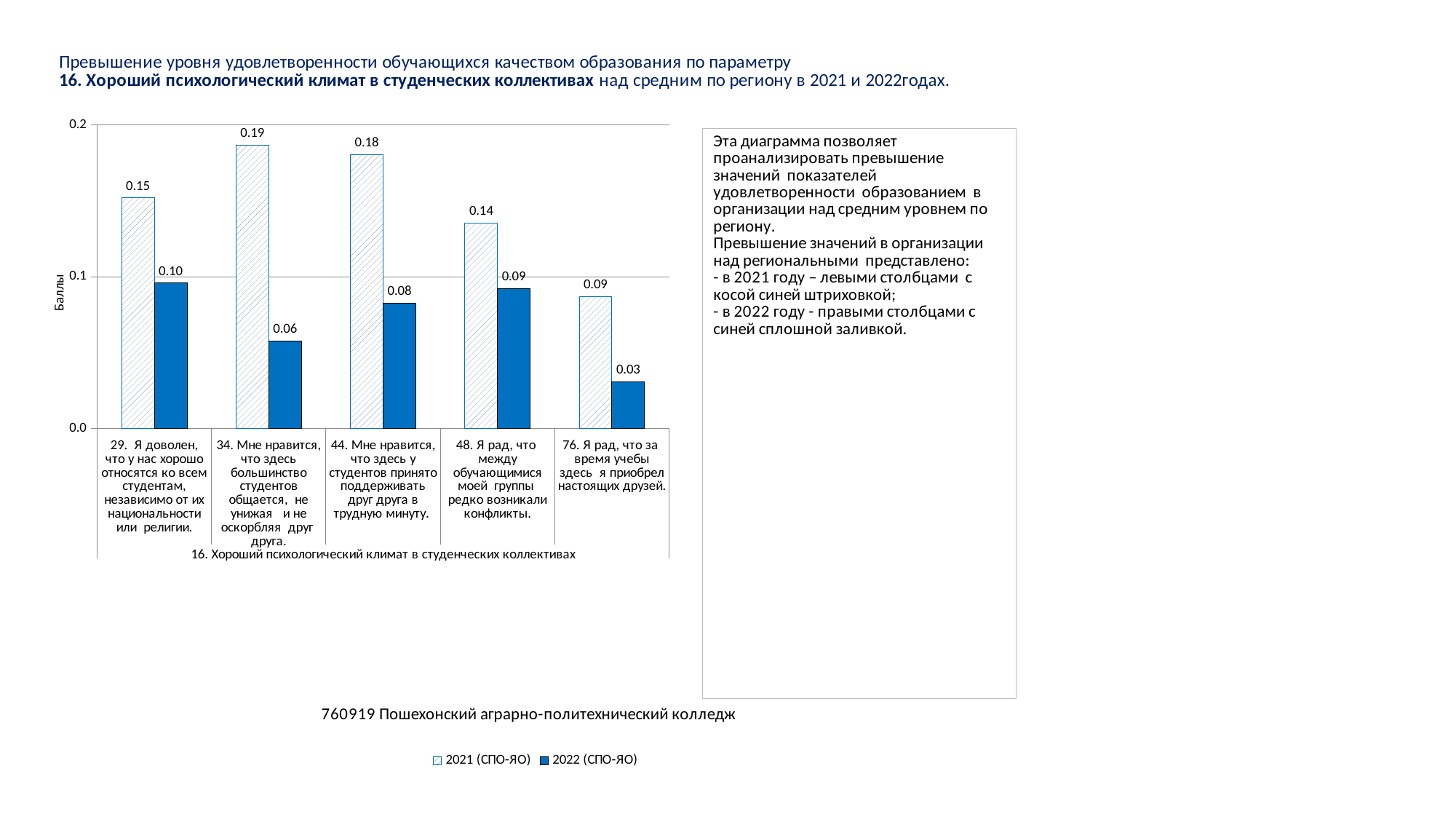
What is the difference between the 2021 values for category 44 and category 48? 0.04 What is the 2021 (СПО-ЯО) value for category 34 ("Мне нравится, что здесь большинство студентов общается, не унижая и не оскорбляя друг друга")? 0.19 What is the difference between the 2021 and 2022 values for category 34? 0.13 What is the 2022 (СПО-ЯО) value for category 29 ("Я доволен, что у нас хорошо относятся ко всем студентам...")? 0.10 What is the 2022 (СПО-ЯО) value for category 76 ("Я рад, что за время учебы здесь я приобрел настоящих друзей")? 0.03 What type of chart is shown on the slide? Bar chart Which category has the highest 2021 (СПО-ЯО) value? 34. Мне нравится, что здесь большинство студентов общается, не унижая и не оскорбляя друг друга. How many series does the legend list? 2 Is the 2021 value for category 76 greater or less than 0.1? less How many categories are shown on the x axis of the chart? 5 Which category has the lowest 2022 (СПО-ЯО) value? 76. Я рад, что за время учебы здесь я приобрел настоящих друзей. Which is larger: the 2022 value for category 48 or the 2022 value for category 44? Category 48 (0.09)